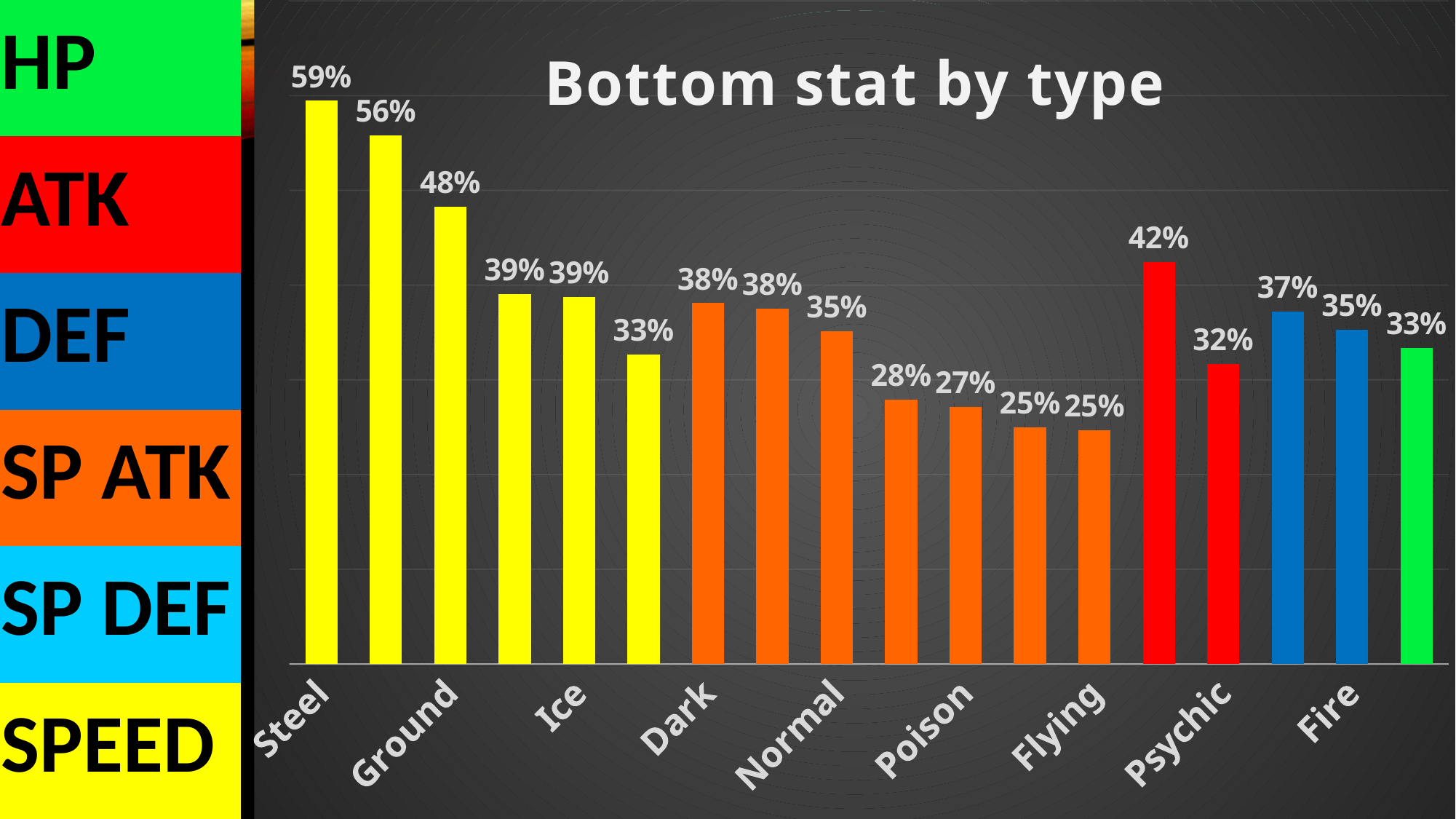
What is the value of the tallest red bar? 42% What is the lowest value shown in the chart? 25% How many bars are plotted in the chart? 18 What is the difference between the value for Steel and the value for Psychic? 27% What is the highest value shown in the chart? 59% What is the value of the bar for Steel? 59% What is the title of the chart? Bottom stat by type Which is larger, the value for Steel or the value for Fire? Steel What is the value of the bar for Psychic? 32% What kind of chart is shown on the slide? bar chart What is the value of the bar for Fire? 35% Which type has the highest value in the chart? Steel